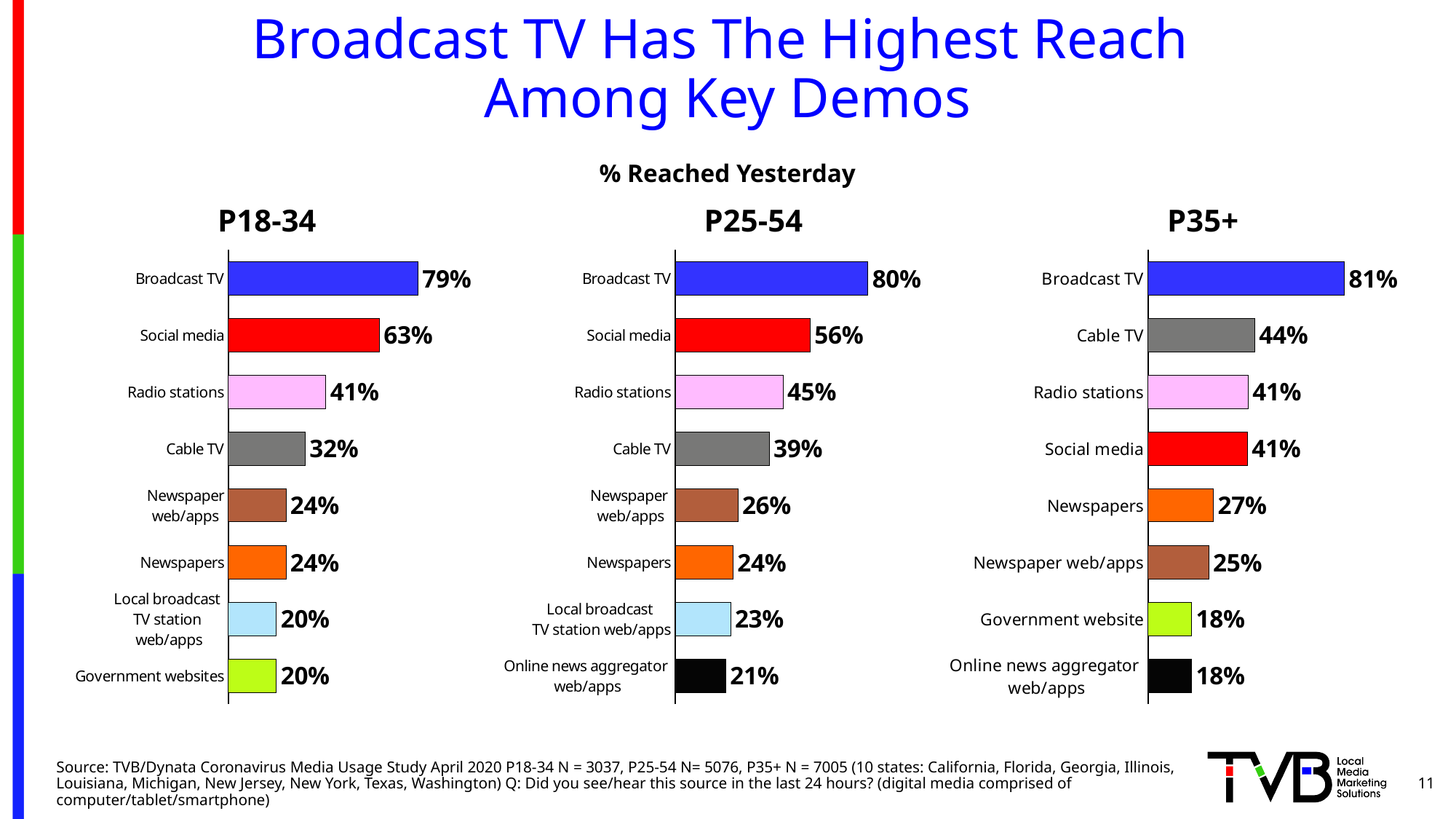
In the P35+ chart, which category has the highest value? Broadcast TV In the P25-54 chart, what is the value for Cable TV? 39% In the P18-34 chart, what is the difference between Broadcast TV and Social media? 16% In the P25-54 chart, which is larger: Radio stations or Cable TV? Radio stations In the P35+ chart, what is the difference between Cable TV and Government website? 26% In the P25-54 chart, which category has the lowest value? Online news aggregator web/apps What kind of chart is the P25-54 chart? bar chart What is the subtitle shown above the three charts? % Reached Yesterday In the P35+ chart, what is the value for Newspapers? 27% How many categories are shown in the P18-34 chart? 8 What is the value for Broadcast TV in the P25-54 chart? 80% In the P18-34 chart, what is the value for Social media? 63%